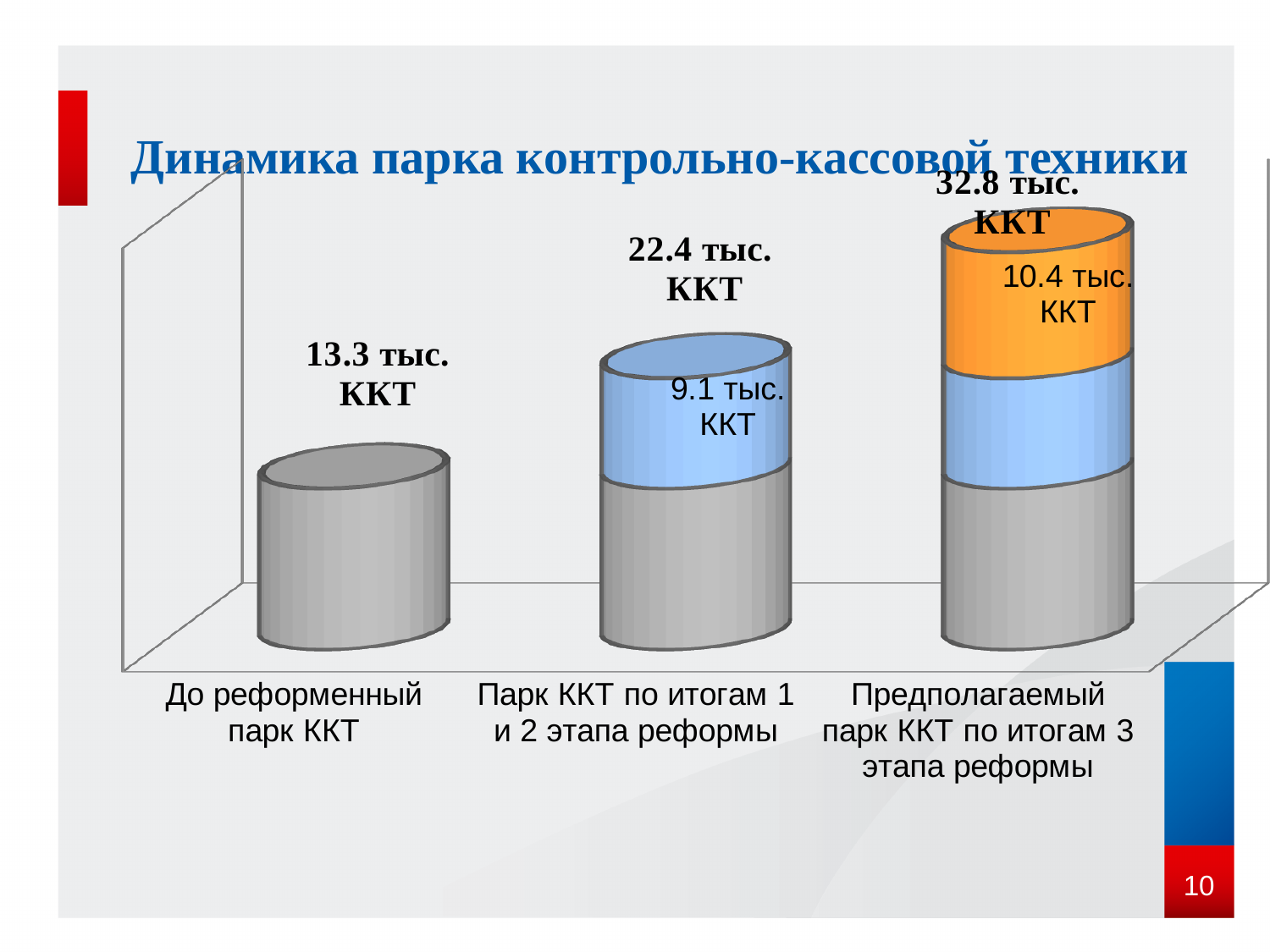
What value is printed on the blue segment of the bar for 'Парк ККТ по итогам 1 и 2 этапа реформы'? 9.1 тыс. ККТ What kind of chart is shown on the slide? Stacked bar chart Which is larger: the total for 'Парк ККТ по итогам 1 и 2 этапа реформы' or the total for 'До реформенный парк ККТ'? Парк ККТ по итогам 1 и 2 этапа реформы What is the total value shown for the category 'До реформенный парк ККТ'? 13.3 тыс. ККТ What is the difference between the total for 'Предполагаемый парк ККТ по итогам 3 этапа реформы' and the total for 'До реформенный парк ККТ'? 19.5 тыс. ККТ Do the total values rise or fall from left to right across the categories? Rise What value is printed on the orange segment of the bar for 'Предполагаемый парк ККТ по итогам 3 этапа реформы'? 10.4 тыс. ККТ What is the total value shown for the category 'Парк ККТ по итогам 1 и 2 этапа реформы'? 22.4 тыс. ККТ What is the total value shown for the category 'Предполагаемый парк ККТ по итогам 3 этапа реформы'? 32.8 тыс. ККТ Which category has the highest total value? Предполагаемый парк ККТ по итогам 3 этапа реформы Which category has the lowest total value? До реформенный парк ККТ How many categories are shown on the chart? 3